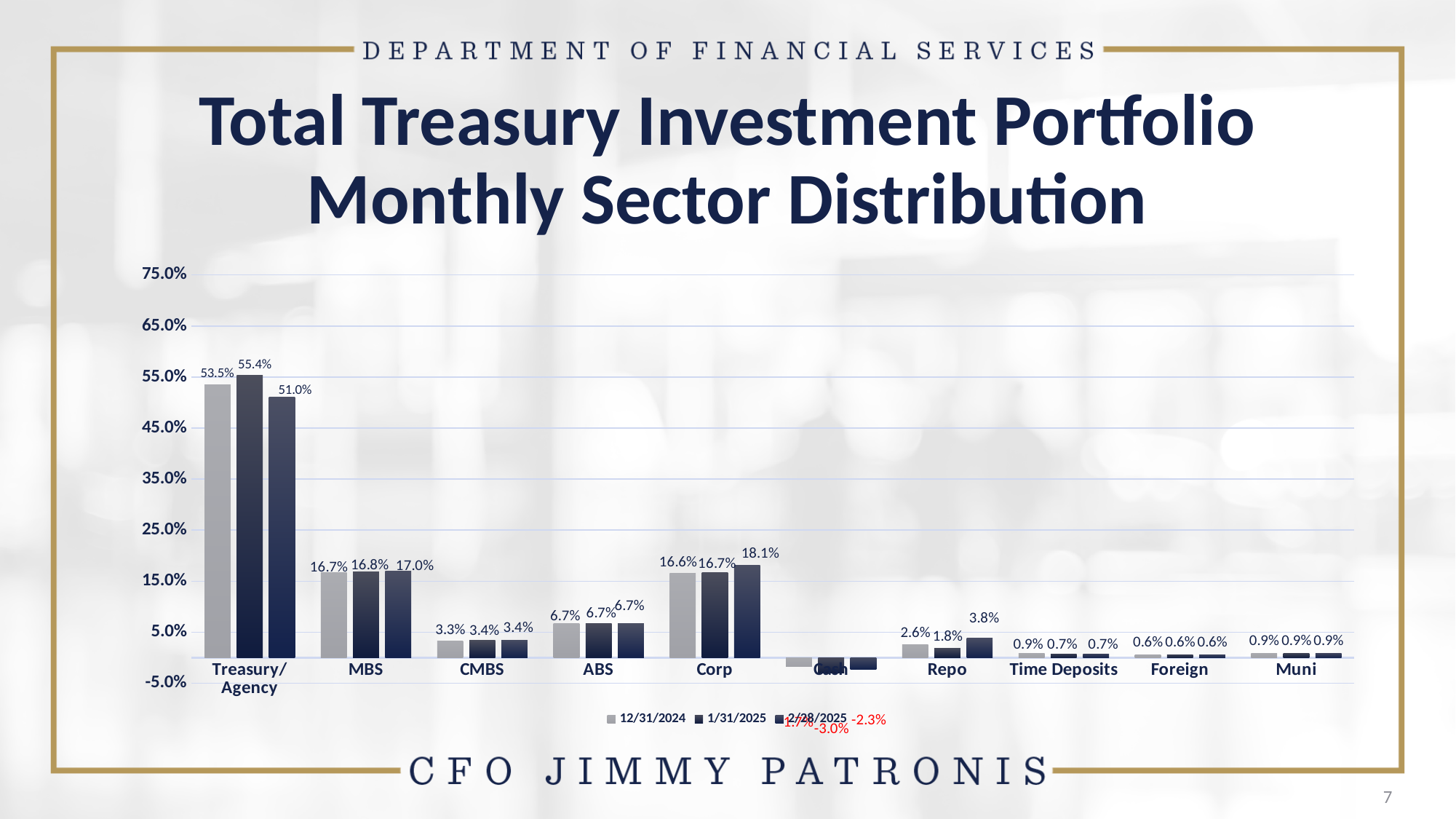
What is the difference between the Repo values for 2/28/2025 and 12/31/2024? 1.2% Which is larger for 12/31/2024: MBS or Corp? MBS What is the difference between the Treasury/Agency values for 1/31/2025 and 2/28/2025? 4.4% How many sector categories are shown on the x axis? 10 What is the value for Repo for 1/31/2025? 1.8% How many series does the legend list? 3 What kind of chart is shown on the slide? Bar chart What is the value for Time Deposits for 12/31/2024? 0.9% What is the value for Corp for 2/28/2025? 18.1% Is the value for Treasury/Agency for 12/31/2024 greater or less than 45.0%? greater What is the value for Treasury/Agency for 2/28/2025? 51.0% Which sector has the highest value for 1/31/2025? Treasury/Agency